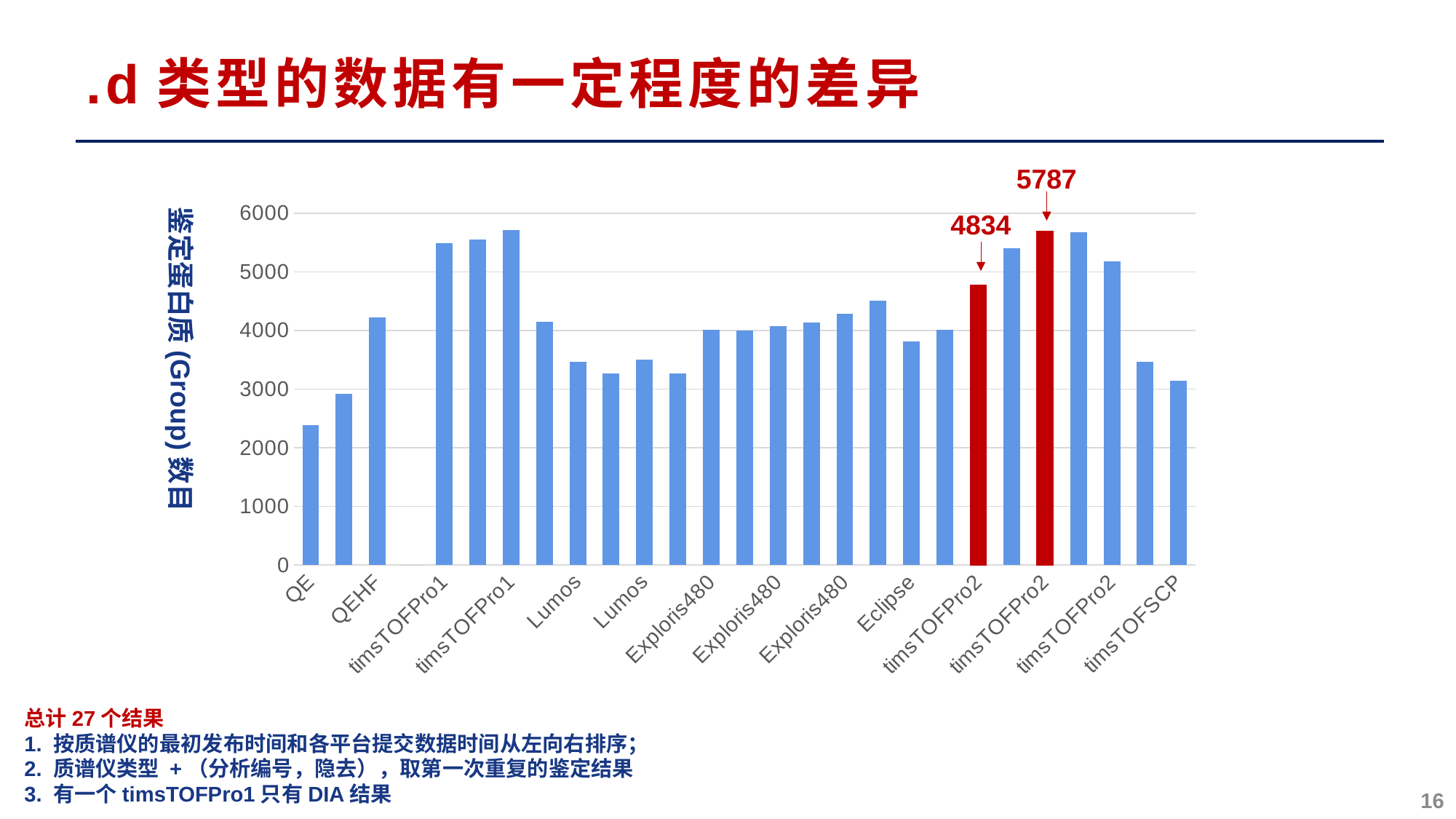
What type of chart is shown on the slide? bar chart What value is printed above the first red-highlighted bar? 4834 Is the value for Eclipse greater or less than 4000? less Is the value for QE greater or less than 3000? less What is the difference between the two labeled values, 5787 and 4834? 953 Is the value for the first timsTOFPro1 bar greater or less than 5000? greater Which category has the lowest bar in the chart? QE Which instrument type do the two red-highlighted bars belong to? timsTOFPro2 Which bar is taller, QE or QEHF? QEHF Which of the two labeled bars is larger, the one labeled 4834 or the one labeled 5787? 5787 What is the label of the vertical axis? 鉴定蛋白质(Group)数目 What value is printed above the second red-highlighted bar? 5787